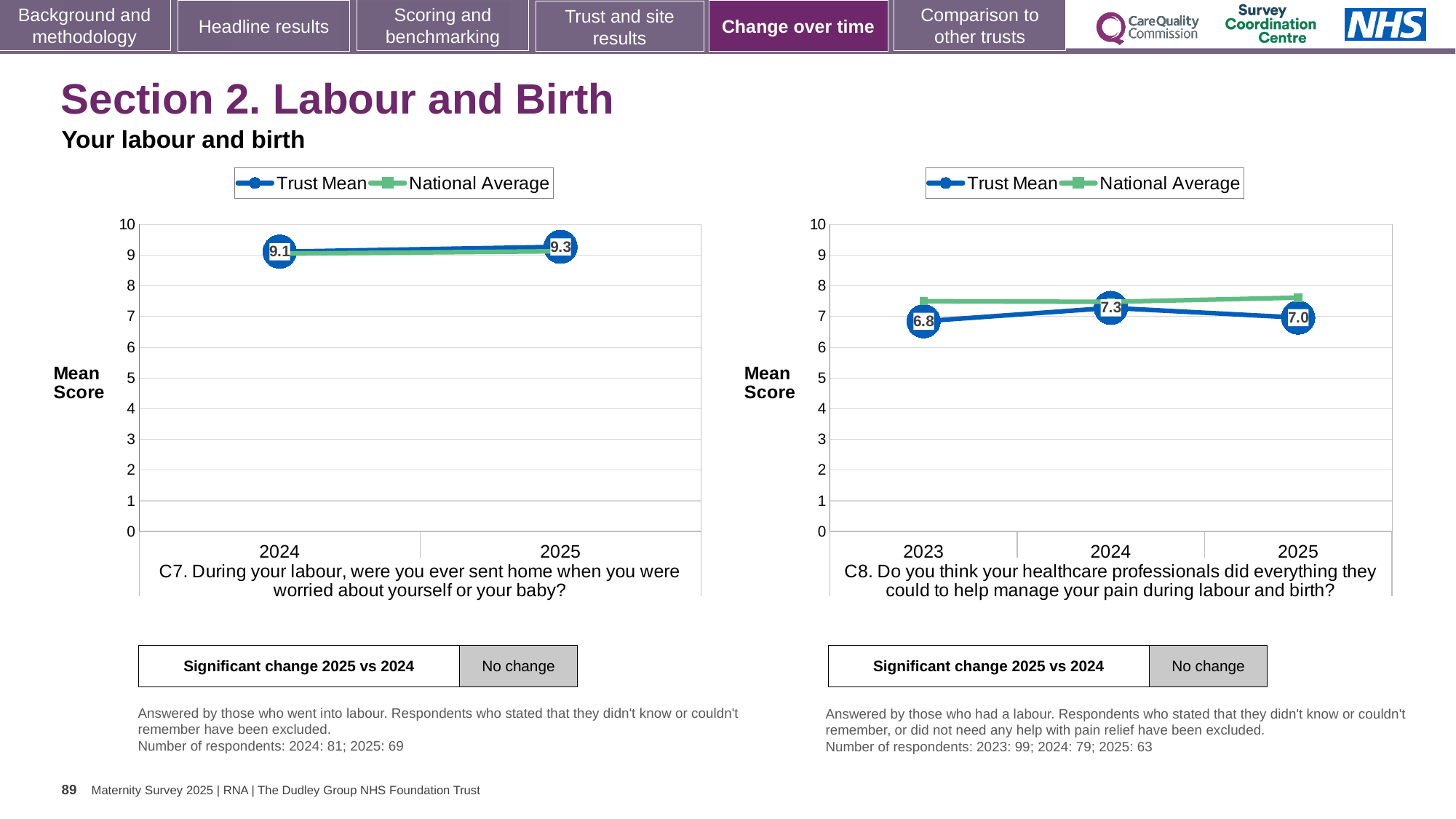
In the C7 chart (left), what is the Trust Mean score for 2025? 9.3 In the C7 chart (left), does the Trust Mean rise or fall from 2024 to 2025? rise How many series does the legend of the C7 chart (left) list? 2 In the C8 chart (right), which year has the highest Trust Mean score? 2024 In the C8 chart (right), is the National Average for 2025 greater or less than 7? greater In the C7 chart (left), what is the Trust Mean score for 2024? 9.1 In the C7 chart (left), by how much did the Trust Mean change from 2024 to 2025? 0.2 In the C8 chart (right), what is the Trust Mean score for 2025? 7.0 In the C8 chart (right), which year has the lowest Trust Mean score? 2023 In the C8 chart (right), what is the Trust Mean score for 2023? 6.8 How many years are shown on the x axis of the C8 chart (right)? 3 In the C8 chart (right), what is the difference between the Trust Mean in 2024 and 2023? 0.5